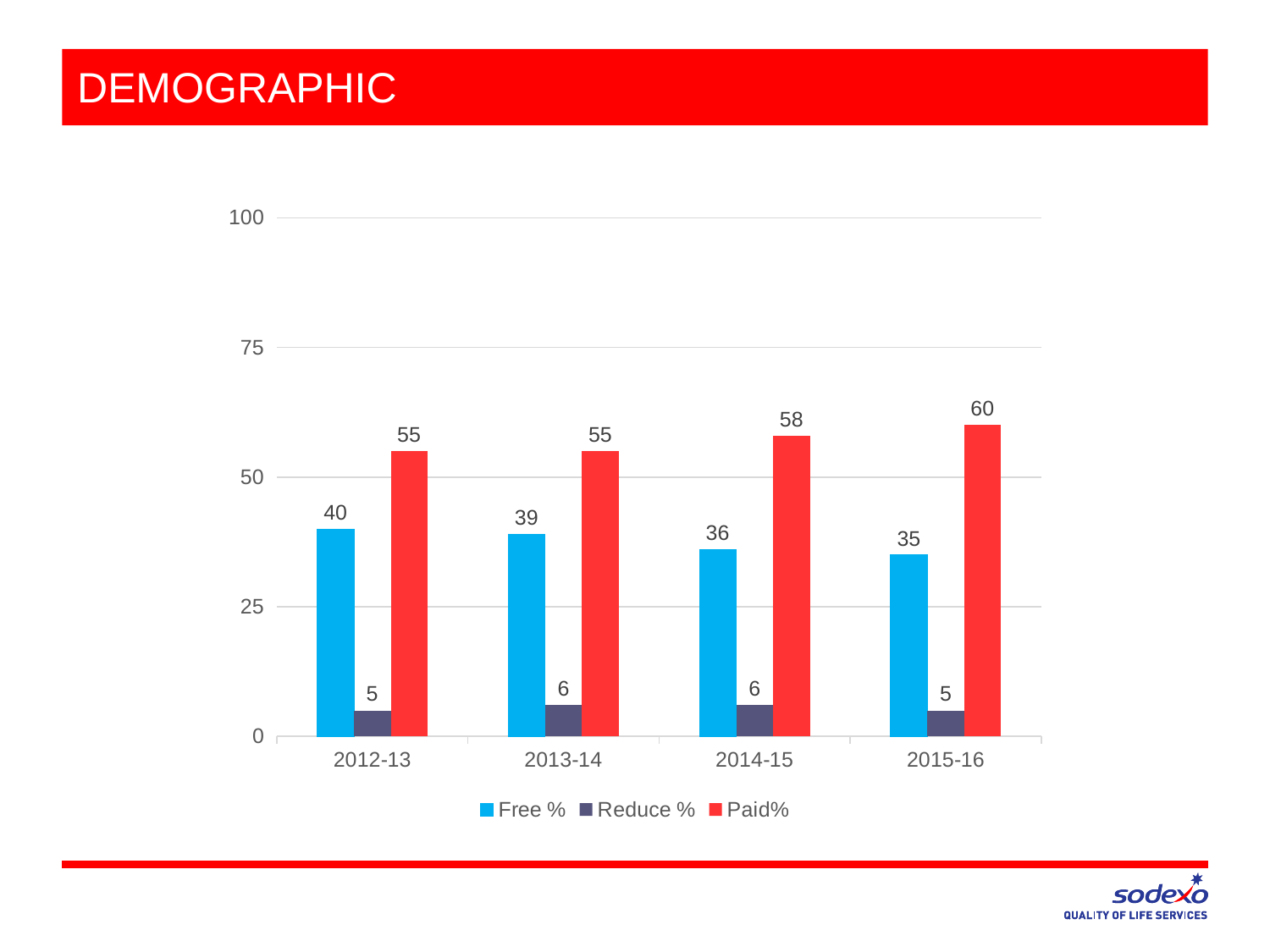
How many series does the legend list? 3 In which year is the Paid% value highest? 2015-16 Does the Free % value rise or fall from 2012-13 to 2015-16? Fall How many years are shown on the x axis? 4 In which year is the Free % value lowest? 2015-16 What kind of chart is shown on the slide? Bar chart What is the Free % value for 2012-13? 40 What is the difference between the Paid% and Free % values in 2014-15? 22 What is the Reduce % value for 2013-14? 6 Which is larger in 2013-14, the Free % value or the Paid% value? Paid% What is the Paid% value for 2015-16? 60 Is the Paid% value for 2012-13 greater or less than 50? greater